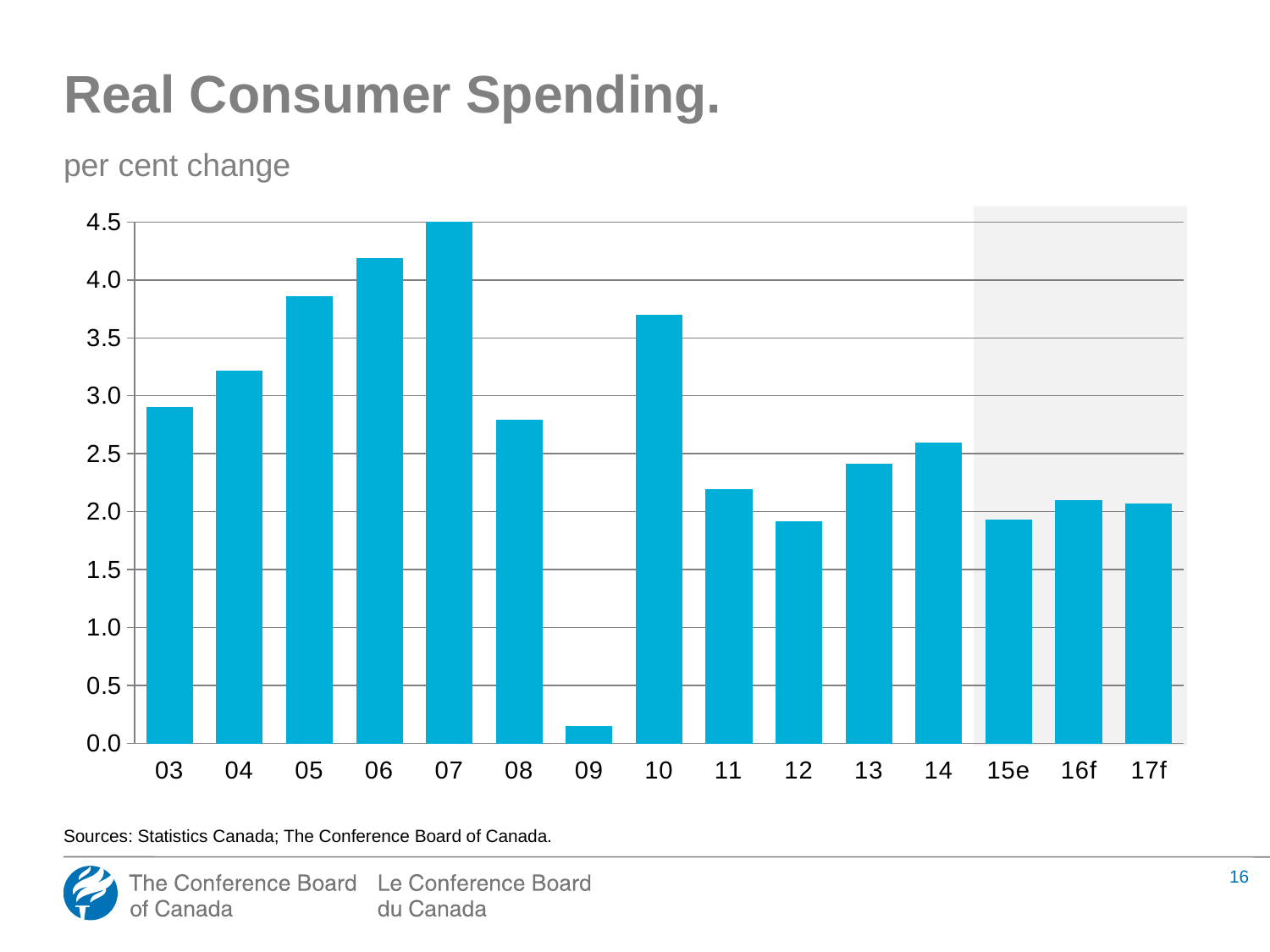
Do the values rise or fall from 03 to 07? rise How many years are shown on the x axis? 15 Which year has the highest real consumer spending growth? 07 Is the value for 06 greater or less than 4.0? greater What kind of chart is shown on the slide? bar chart Which is larger, the value for 05 or the value for 08? 05 Is the value for 10 greater or less than 3.5? greater Is the value for 09 greater or less than 0.5? less What unit is the chart measured in, according to the subtitle? per cent change Which is larger, the value for 14 or the value for 11? 14 Which year has the lowest real consumer spending growth? 09